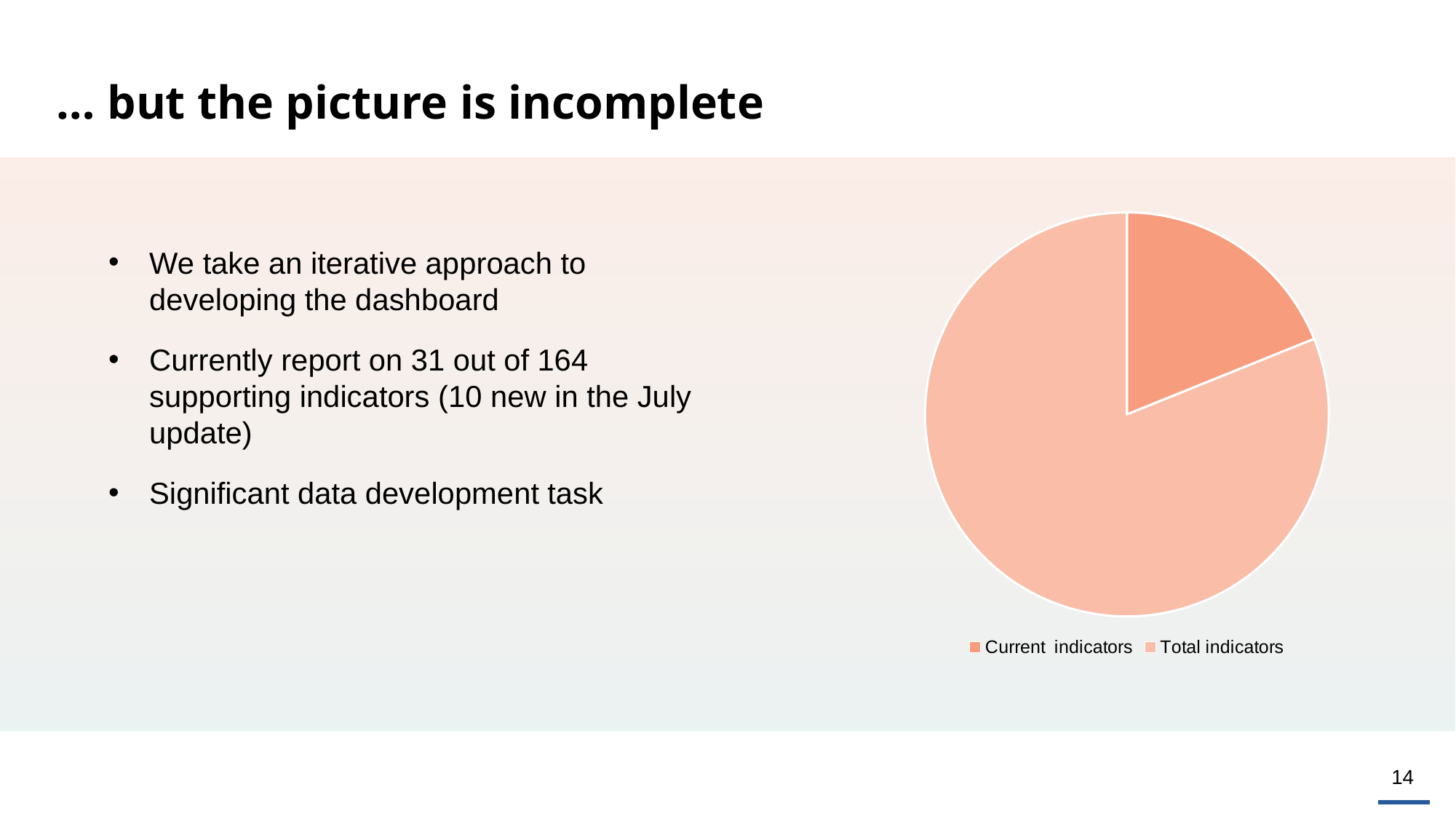
Which legend entry is shown in the darker orange colour in the pie chart? Current indicators How many slices does the pie chart have? 2 Which category takes up the smallest share of the pie chart? Current indicators Which category takes up the largest share of the pie chart? Total indicators What kind of chart is shown on the slide? Pie chart Which slice of the pie chart is larger, Current indicators or Total indicators? Total indicators How many entries does the pie chart's legend list? 2 What are the two categories listed in the pie chart's legend? Current indicators and Total indicators